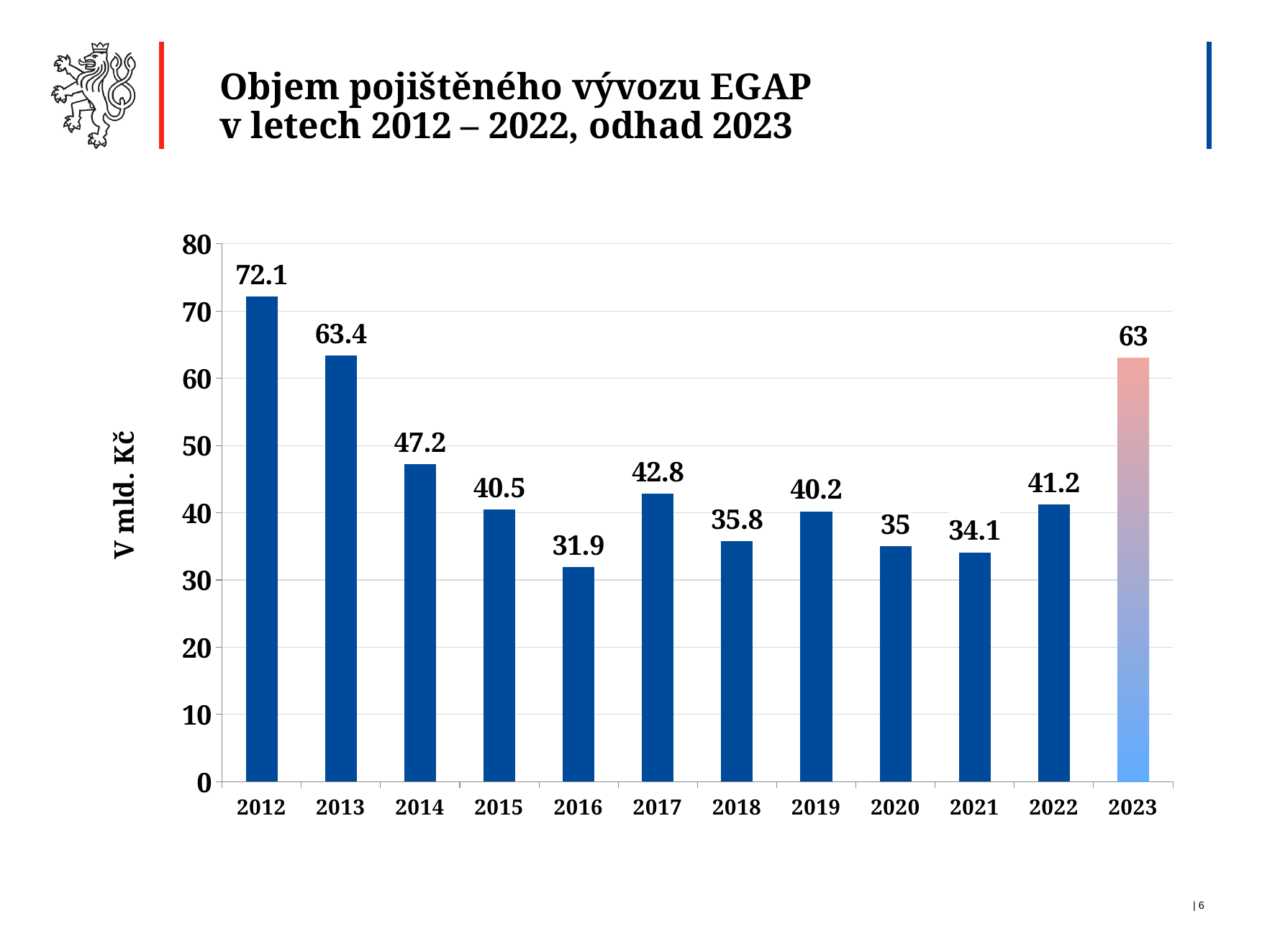
Which year has the highest value? 2012 What is the value for 2012? 72.1 What is the estimated value for 2023? 63 What is the difference between the values for 2012 and 2013? 8.7 Which is larger, the value for 2017 or the value for 2019? 2017 What is the label of the vertical axis? V mld. Kč What is the difference between the values for 2022 and 2021? 7.1 How many years are shown on the x axis? 12 What is the value for 2016? 31.9 Is the value for 2014 greater or less than 50? less Which year has the lowest value? 2016 What kind of chart is shown on the slide? bar chart